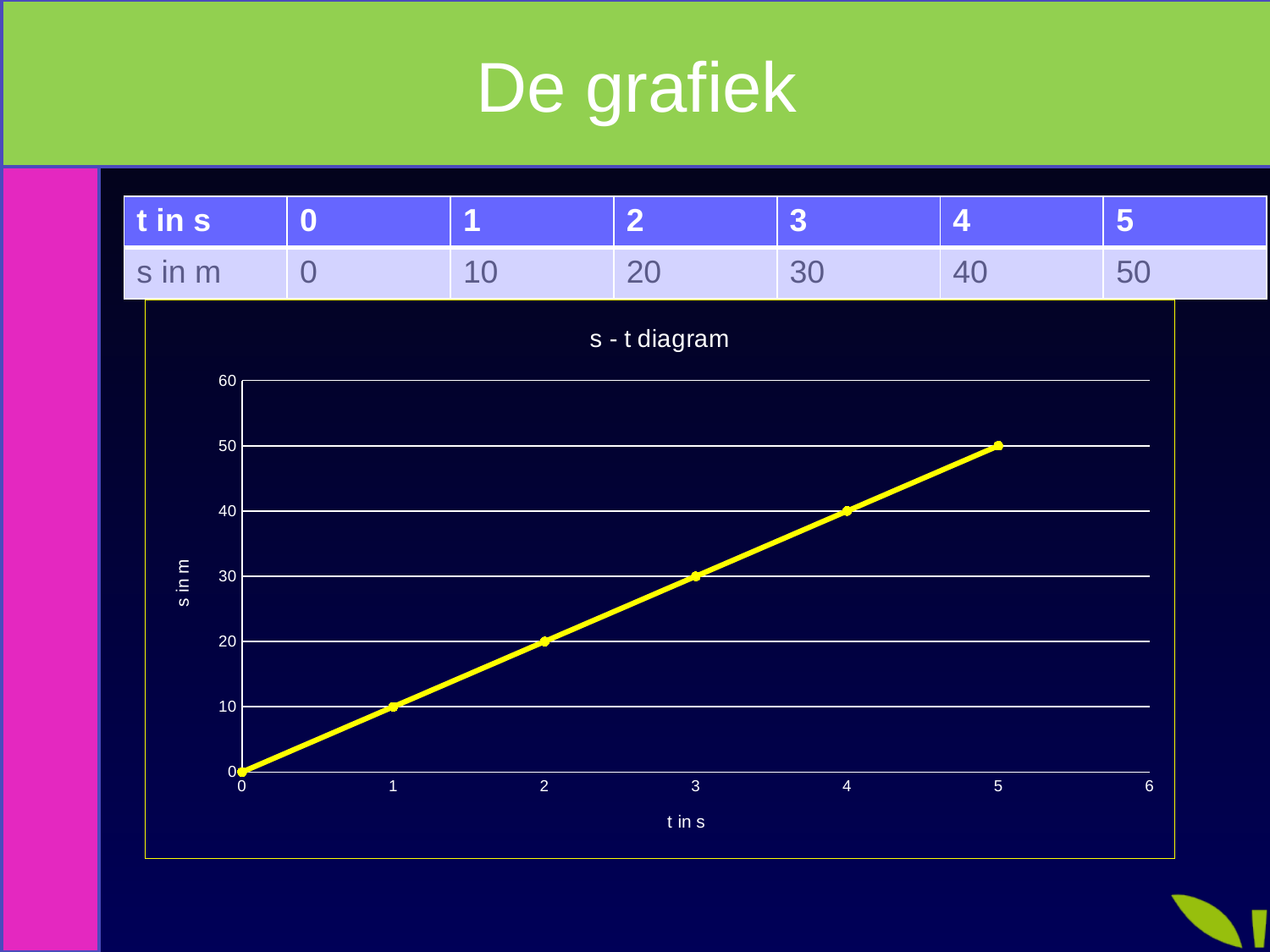
At which value of t is s highest? 5 At which value of t is s lowest? 0 What is the value of s at t = 3 s? 30 What is the difference between s at t = 4 s and s at t = 2 s? 20 What is the value of s at t = 1 s? 10 What kind of chart is the s - t diagram? line chart Which is larger, s at t = 2 s or s at t = 4 s? s at t = 4 s What is the value of s at t = 5 s? 50 Does s rise or fall as t increases? rise What is the label of the vertical axis? s in m What is the title of the chart? s - t diagram How many data points are plotted on the line? 6